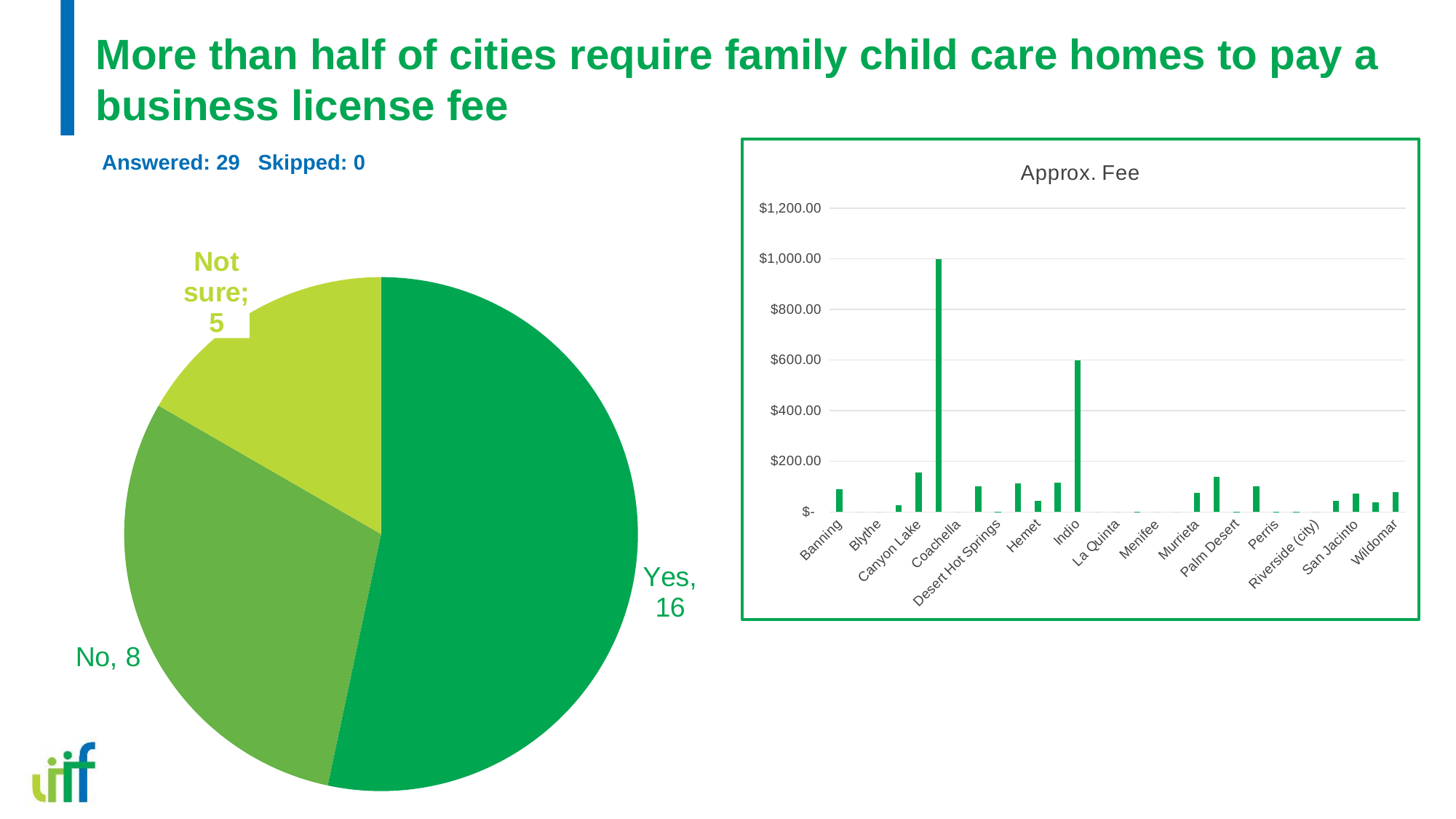
How many slices does the pie chart on the left have? 3 In the 'Approx. Fee' chart, is the value for Indio greater or less than $400.00? greater In the pie chart on the left, what is the value for No? 8 What kind of chart is the 'Approx. Fee' chart on the right? bar chart In the pie chart on the left, which response has the smallest slice? Not sure In the pie chart on the left, how many cities answered Yes? 16 In the 'Approx. Fee' chart, which has the larger fee, Coachella or Indio? Indio What kind of chart is the chart on the left of the slide? pie chart In the pie chart on the left, what is the value for Not sure? 5 In the pie chart on the left, which response has the largest slice? Yes In the pie chart on the left, how many more cities answered Yes than No? 8